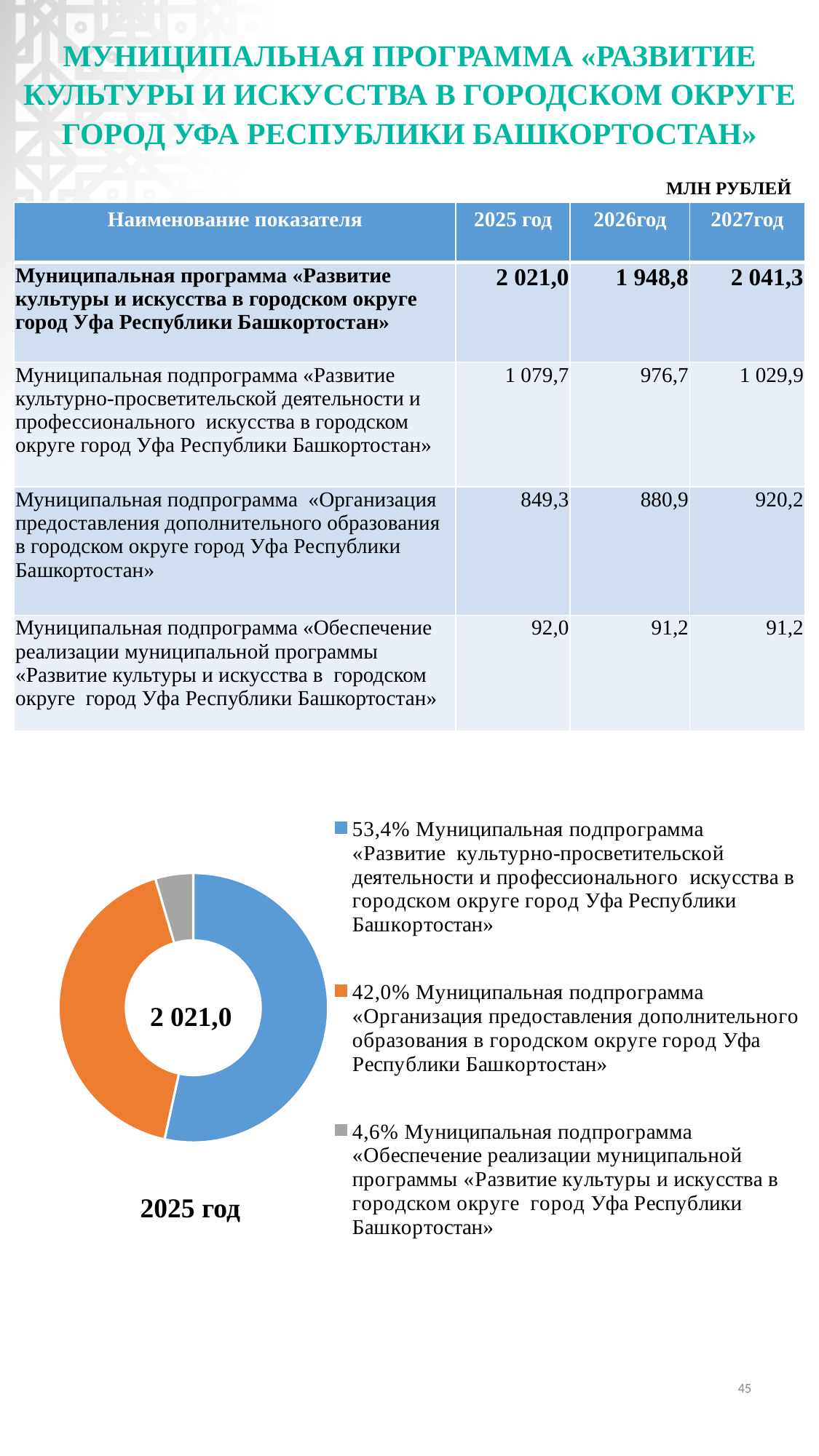
What colour is the slice for the subprogram «Организация предоставления дополнительного образования...» in the pie chart? orange How many slices does the pie chart for 2025 год have? 3 What is the difference in percentage points between the 53,4% slice and the 42,0% slice in the pie chart? 11,4 Which subprogram has the largest slice in the pie chart? Муниципальная подпрограмма «Развитие культурно-просветительской деятельности и профессионального искусства в городском округе город Уфа Республики Башкортостан» What share of the pie chart does the subprogram «Развитие культурно-просветительской деятельности и профессионального искусства...» have? 53,4% Which slice is larger in the pie chart: the one for «Организация предоставления дополнительного образования...» or the one for «Обеспечение реализации муниципальной программы...»? «Организация предоставления дополнительного образования...» (42,0%) What share of the pie chart does the subprogram «Обеспечение реализации муниципальной программы...» have? 4,6% What kind of chart is shown at the bottom of the slide? pie chart (donut) Which subprogram has the smallest slice in the pie chart? Муниципальная подпрограмма «Обеспечение реализации муниципальной программы «Развитие культуры и искусства в городском округе город Уфа Республики Башкортостан» Which year does the pie chart represent? 2025 год What total value is printed in the centre of the donut chart? 2 021,0 What share of the pie chart does the subprogram «Организация предоставления дополнительного образования...» have? 42,0%